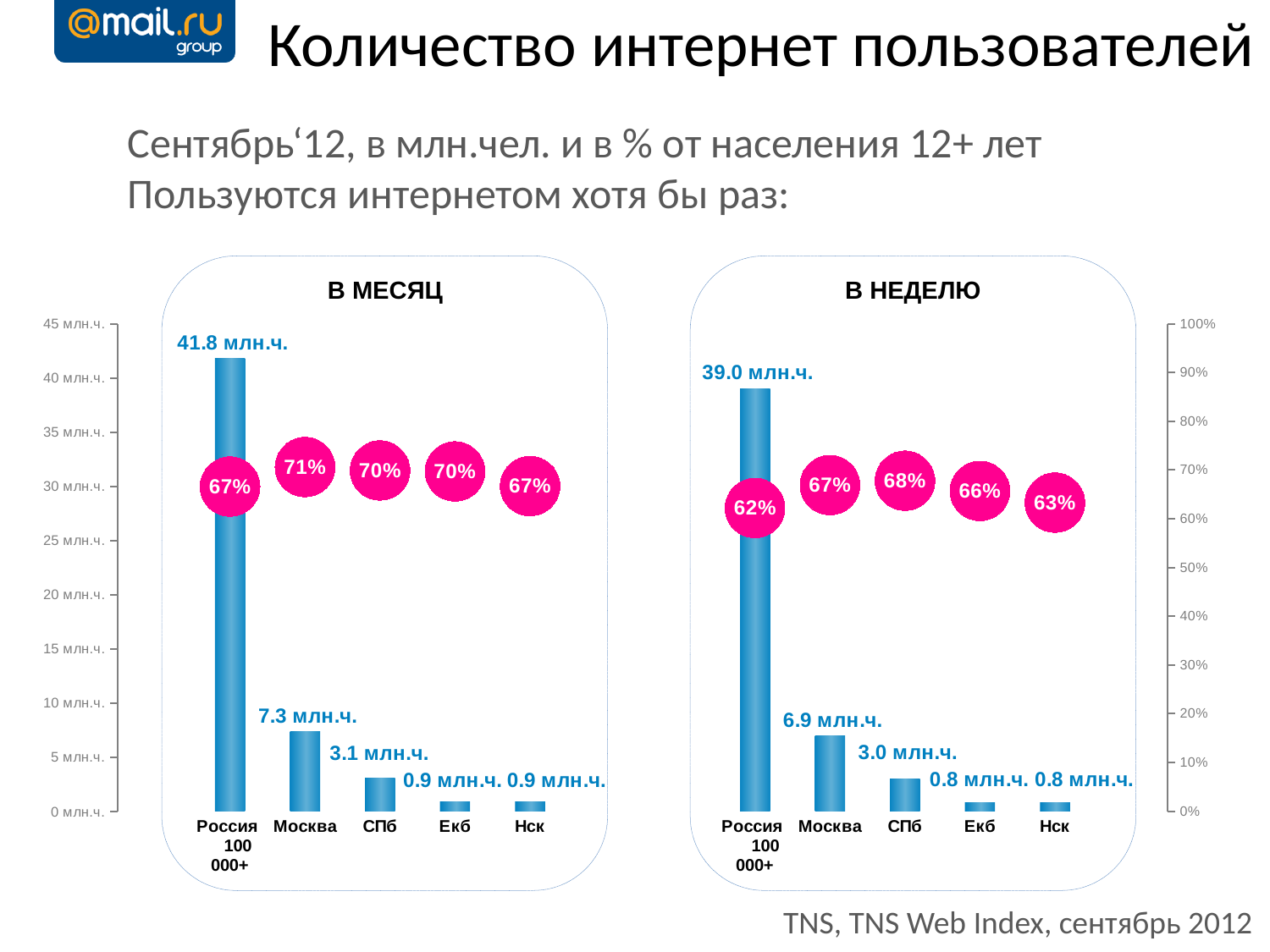
In the "В НЕДЕЛЮ" chart, what is the value for Россия 100 000+? 39.0 млн.ч. In the "В МЕСЯЦ" chart, which category has the highest value in млн.ч.? Россия 100 000+ How many categories are shown in the "В МЕСЯЦ" chart? 5 In the "В НЕДЕЛЮ" chart, which is larger: the value for Москва or the value for СПб? Москва In the "В НЕДЕЛЮ" chart, what is the value for СПб? 3.0 млн.ч. In the "В НЕДЕЛЮ" chart, what percentage is shown for Нск? 63% In the "В МЕСЯЦ" chart, what is the difference between the values for Россия 100 000+ and Москва? 34.5 млн.ч. What kind of chart is the "В НЕДЕЛЮ" chart? Bar chart In the "В МЕСЯЦ" chart, what is the value for Москва? 7.3 млн.ч. What is the title of the chart on the left side of the slide? В МЕСЯЦ In the "В НЕДЕЛЮ" chart, which category has the lowest percentage? Россия 100 000+ In the "В МЕСЯЦ" chart, what percentage is shown for Москва? 71%